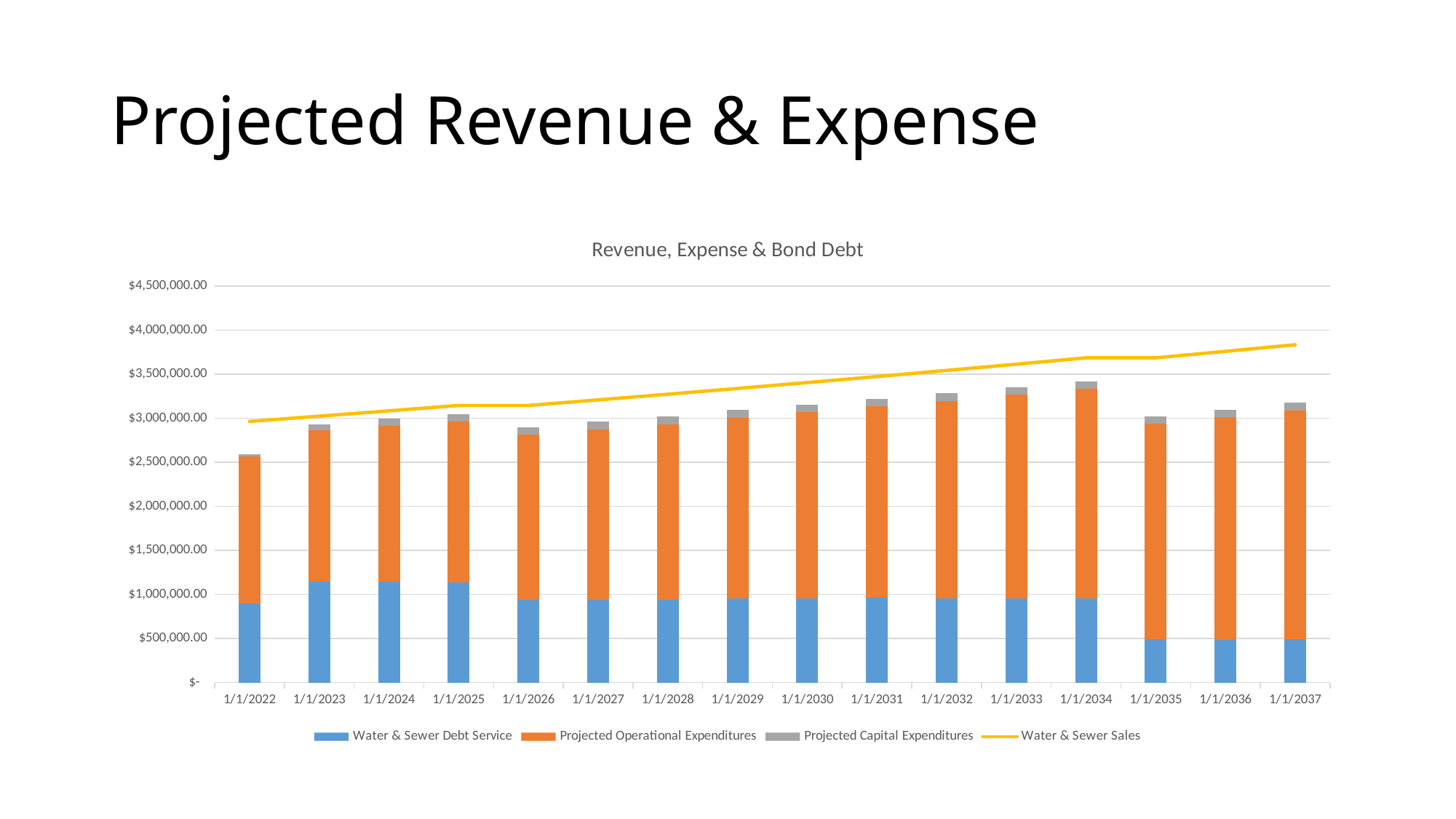
Which date has the shortest stacked expense bar? 1/1/2022 Is the Water & Sewer Sales value for 1/1/2037 greater or less than $3,500,000.00? greater How many dates are shown along the x axis? 16 What is the title of the chart? Revenue, Expense & Bond Debt Does the Water & Sewer Sales line rise or fall from 1/1/2022 to 1/1/2037? Rise How many series does the legend list? 4 Is the Water & Sewer Debt Service value for 1/1/2036 greater or less than $1,000,000.00? less What kind of chart is shown on the slide? Combination stacked bar and line chart What colour is the Water & Sewer Sales line? Yellow Which is larger, the Water & Sewer Debt Service value for 1/1/2024 or for 1/1/2036? 1/1/2024 Which date has the tallest stacked expense bar? 1/1/2034 Is the Water & Sewer Debt Service value for 1/1/2023 greater or less than $1,000,000.00? greater